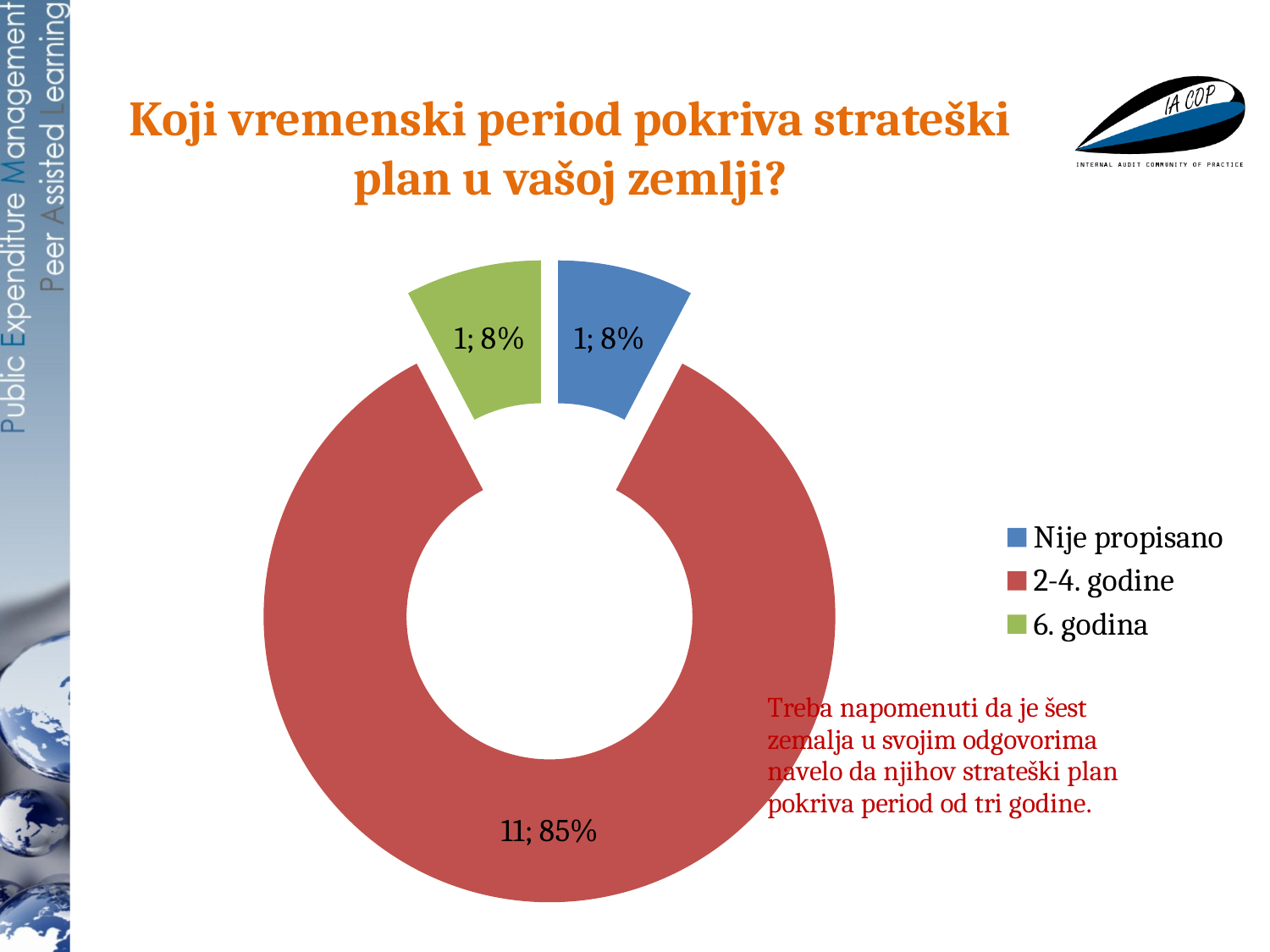
What colour is the '2-4. godine' slice? Red Which category has the largest slice? 2-4. godine What is the count and percentage shown for the 'Nije propisano' slice? 1; 8% What share of the chart does the '6. godina' slice represent? 8% What is the count and percentage shown for the '2-4. godine' slice? 11; 85% What kind of chart is shown on the slide? Doughnut chart How many categories does the legend list? 3 What is the count and percentage shown for the '6. godina' slice? 1; 8% What share of the chart does the '2-4. godine' slice represent? 85% Which is larger, the '2-4. godine' slice or the '6. godina' slice? 2-4. godine What is the total count across all slices of the chart? 13 What is the difference in count between the '2-4. godine' slice and the 'Nije propisano' slice? 10